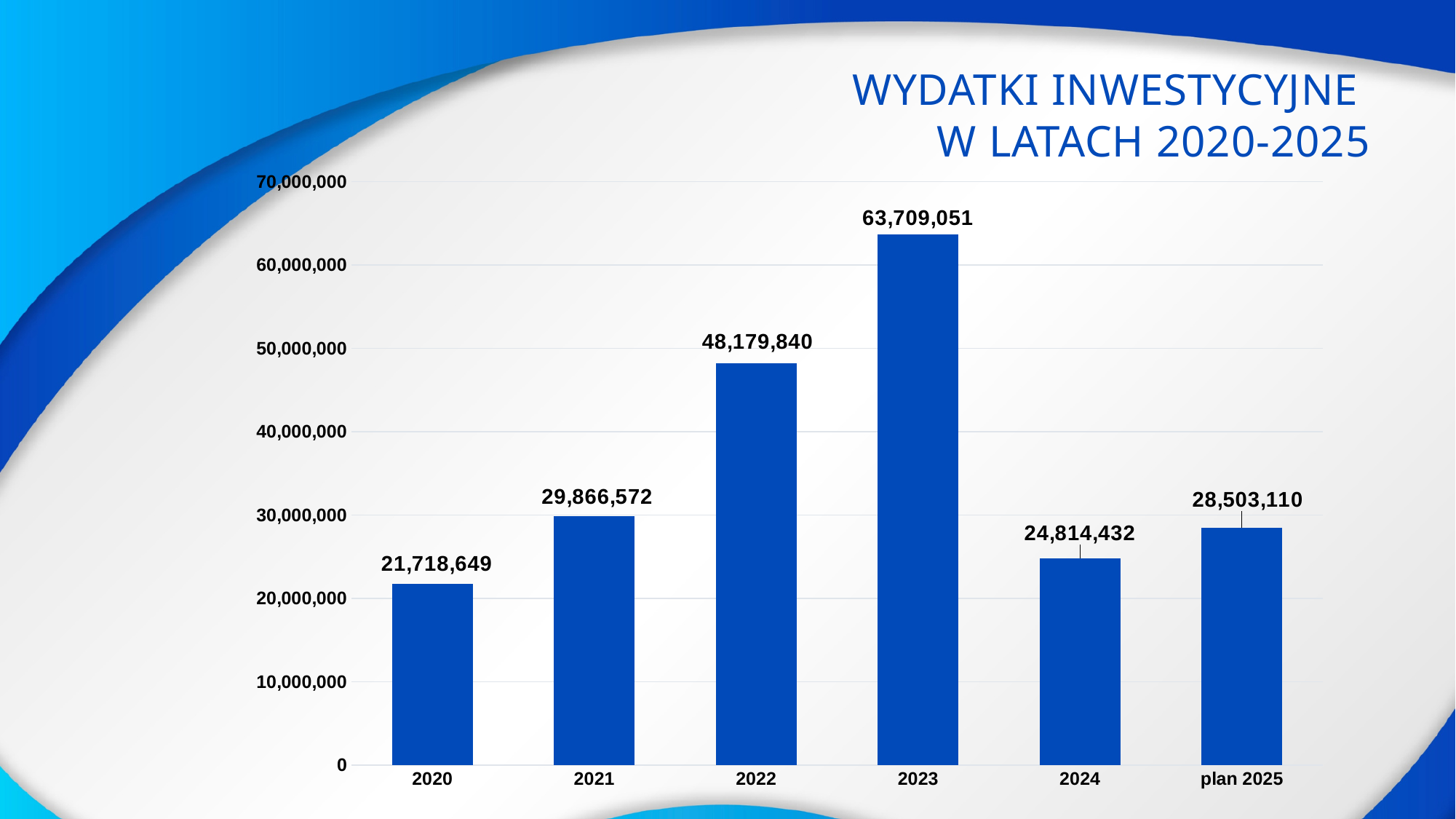
Is the value for 2022 greater or less than 40,000,000? greater What is the value for 2023? 63,709,051 What kind of chart is shown on the slide? bar chart Which is larger, the value for 2024 or the value for plan 2025? plan 2025 How many categories are shown on the x axis? 6 What is the difference between the values for 2022 and 2021? 18,313,268 Do the values rise or fall from 2020 to 2023? rise Which year has the highest value? 2023 What is the value for plan 2025? 28,503,110 Which category has the lowest value? 2020 What is the value for 2020? 21,718,649 What is the difference between the values for 2023 and 2020? 41,990,402